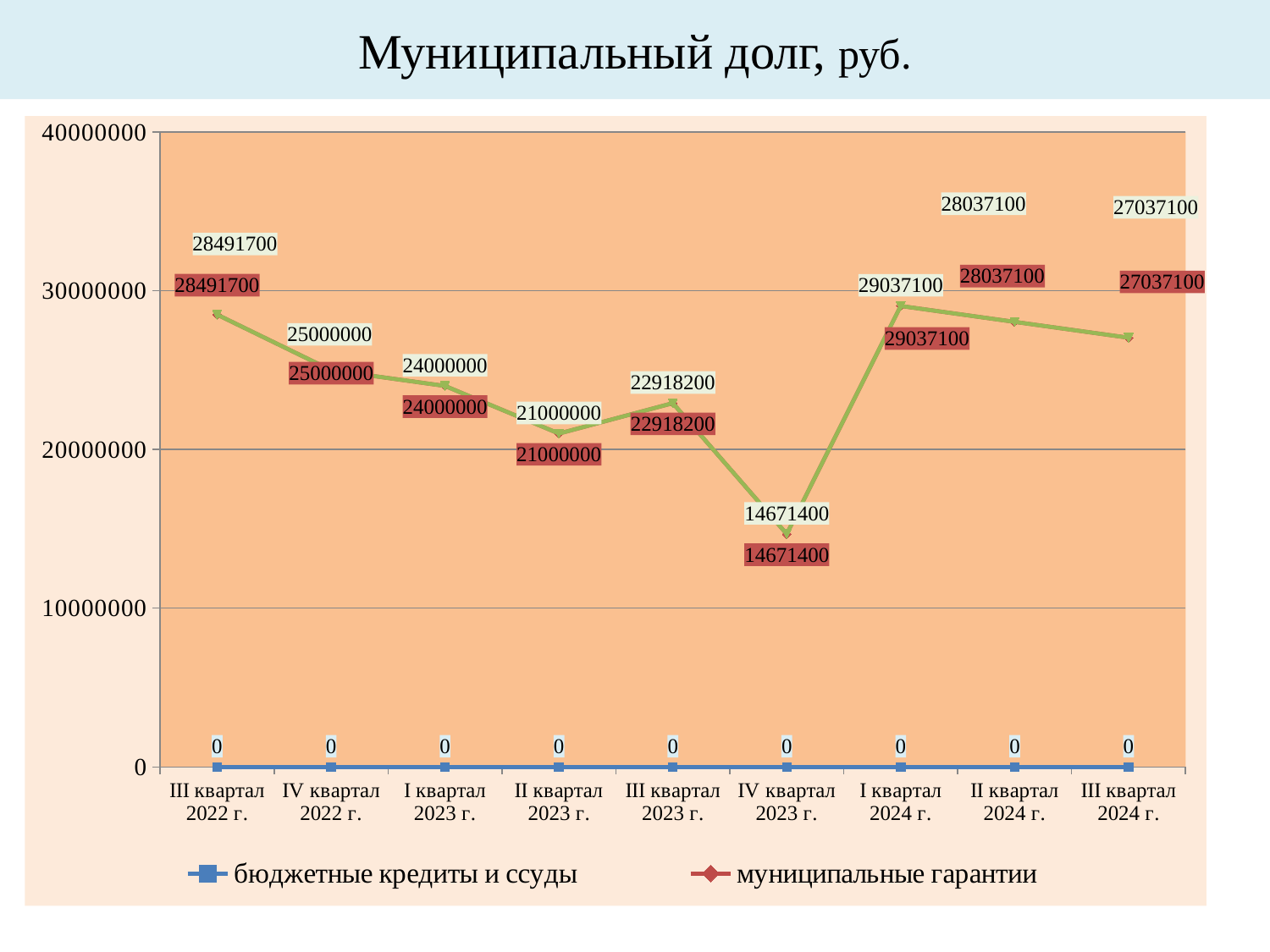
Which is larger for муниципальные гарантии: III квартал 2022 г. or IV квартал 2022 г.? III квартал 2022 г. In which quarter is муниципальные гарантии lowest? IV квартал 2023 г. What is the difference between муниципальные гарантии in I квартал 2024 г. and IV квартал 2023 г.? 14365700 What is the difference between муниципальные гарантии in II квартал 2024 г. and III квартал 2024 г.? 1000000 What is the value of бюджетные кредиты и ссуды for II квартал 2023 г.? 0 What is the value of муниципальные гарантии for III квартал 2022 г.? 28491700 Is the value of муниципальные гарантии for II квартал 2023 г. greater or less than 20000000? greater In which quarter is муниципальные гарантии highest? I квартал 2024 г. How many series does the legend list? 2 What is the value of муниципальные гарантии for IV квартал 2023 г.? 14671400 What is the title of the chart? Муниципальный долг, руб. How many quarters are shown on the x axis? 9